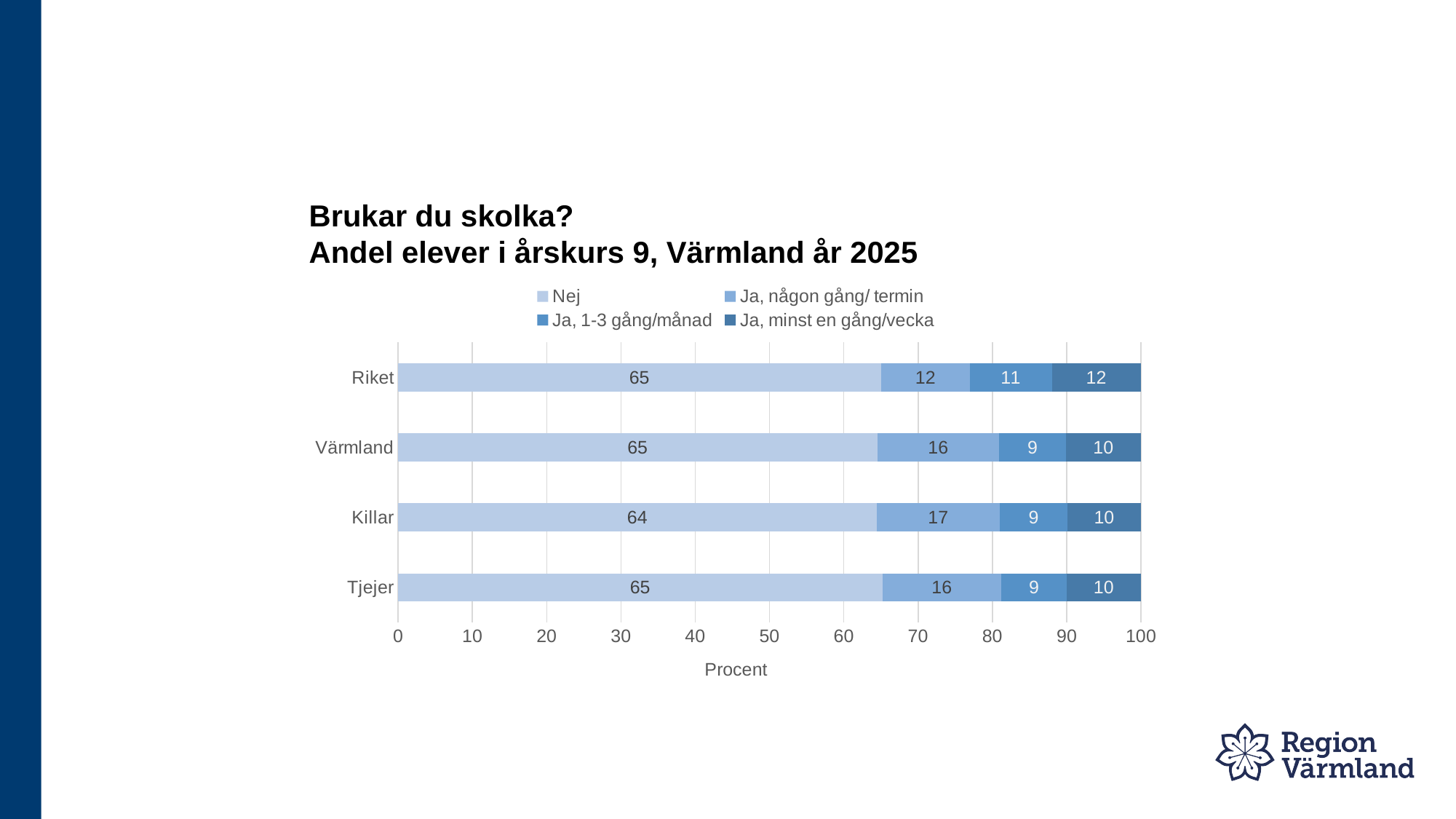
What is the value for "Ja, någon gång/ termin" for Killar? 17 What is the value for "Ja, 1-3 gång/månad" for Tjejer? 9 What is the difference between the "Ja, någon gång/ termin" values for Killar and Riket? 5 What is the value for "Ja, minst en gång/vecka" for Riket? 12 Which category has the lowest value for "Nej"? Killar What is the value for "Nej" for Riket? 65 Which category has the highest value for "Ja, 1-3 gång/månad"? Riket What kind of chart is shown? Stacked bar chart What is the total of the stacked bar for Värmland? 100 How many categories are shown on the y axis? 4 How many series does the legend list? 4 Which is larger: the "Ja, minst en gång/vecka" value for Riket or for Värmland? Riket